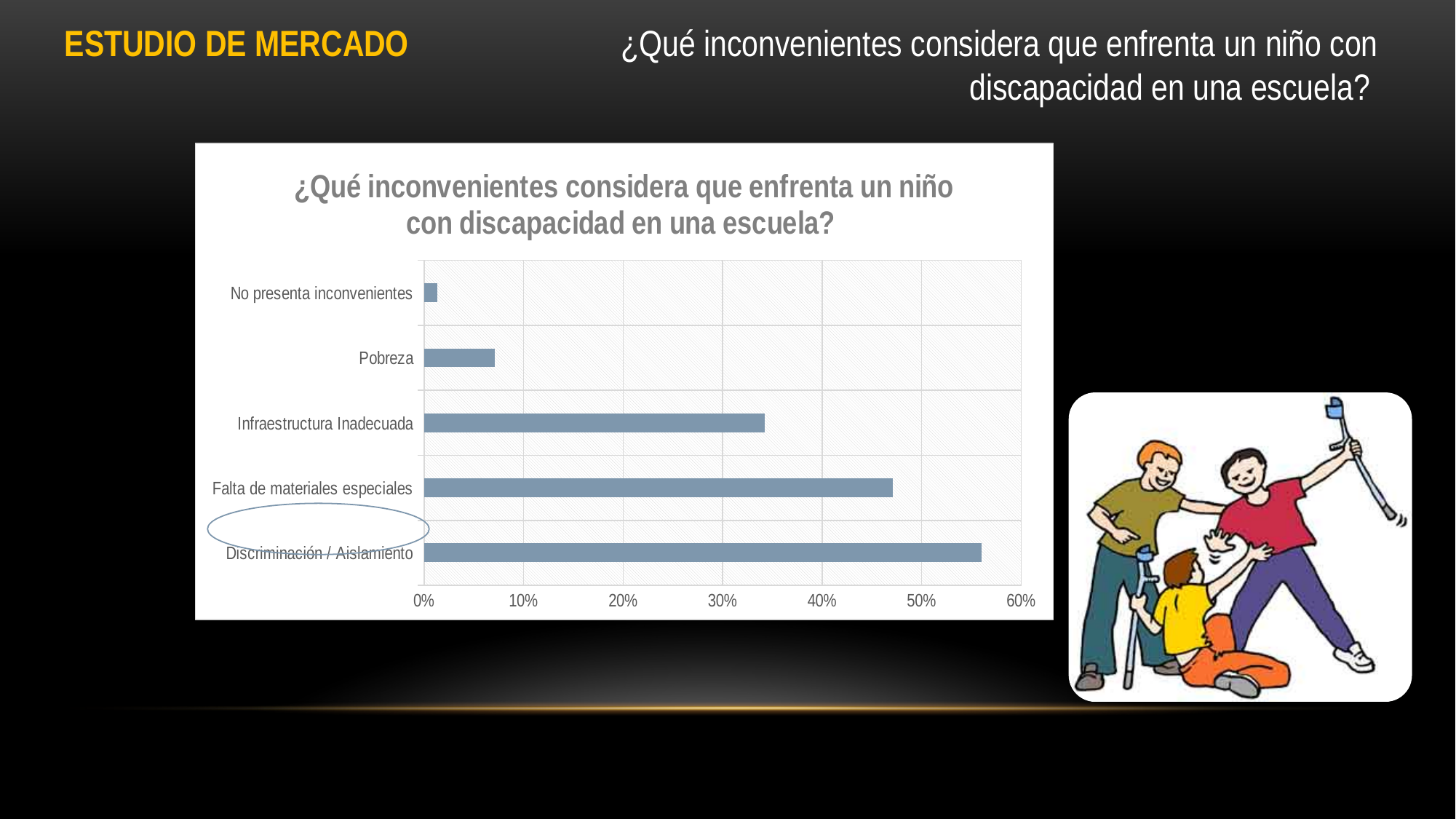
Is the value for Falta de materiales especiales greater or less than 50%? less What is the maximum value shown on the horizontal axis of the chart? 60% Which category has the highest value? Discriminación / Aislamiento Is the value for Infraestructura Inadecuada greater or less than 30%? greater Is the value for Discriminación / Aislamiento greater or less than 50%? greater What kind of chart is shown on the slide? Bar chart What is the title of the chart? ¿Qué inconvenientes considera que enfrenta un niño con discapacidad en una escuela? How many categories are plotted in the chart? 5 Which is larger, the value for Infraestructura Inadecuada or the value for Falta de materiales especiales? Falta de materiales especiales Which is larger, the value for Pobreza or the value for No presenta inconvenientes? Pobreza Which category has the lowest value? No presenta inconvenientes